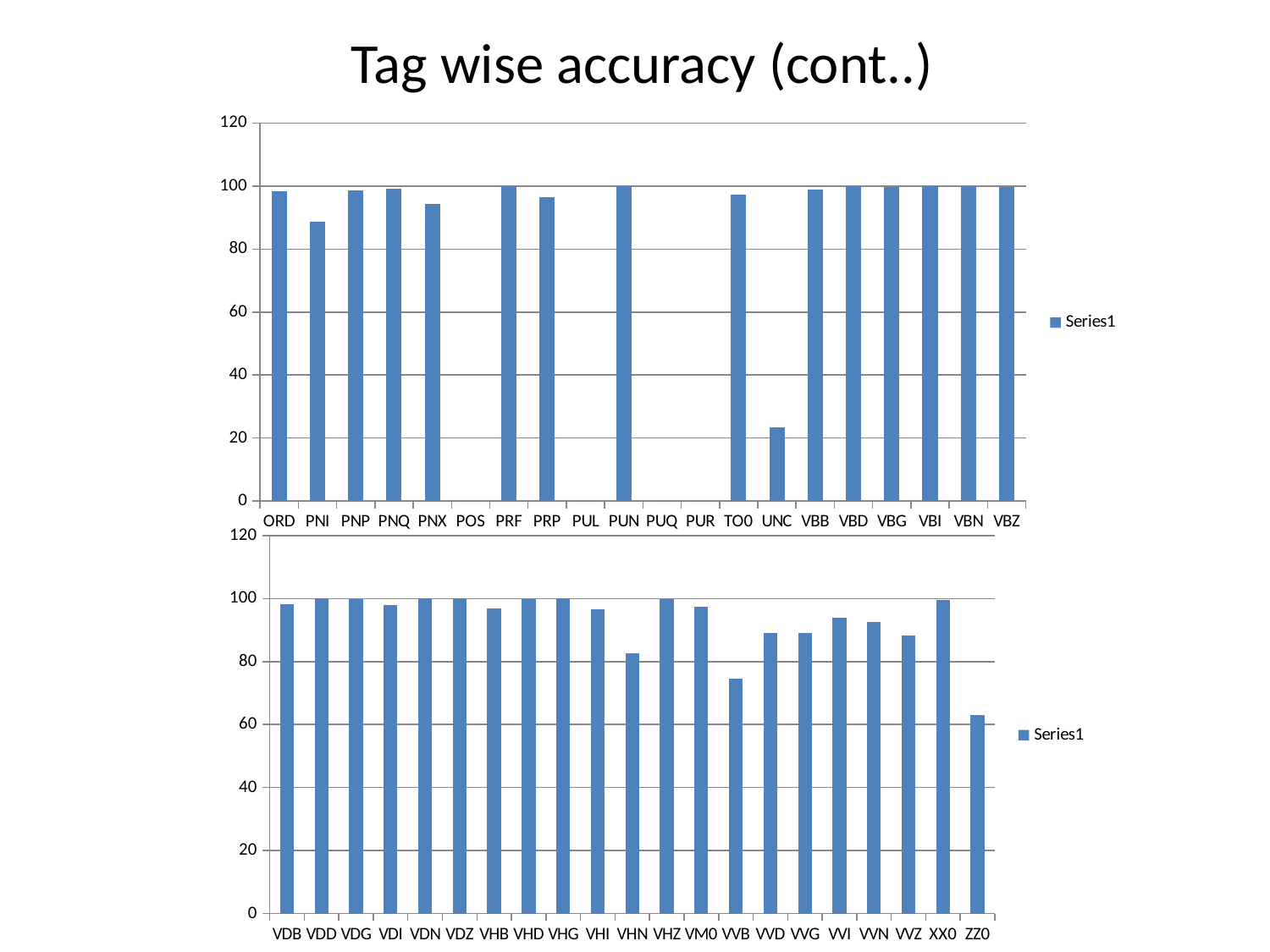
What is the title of the slide? Tag wise accuracy (cont..) How many series does the legend of the bottom chart list? 1 In the bottom chart, is the value for ZZ0 greater or less than 80? less In the top chart, is the value for UNC greater or less than 40? less In the bottom chart, how many categories are shown on the x axis? 21 In the bottom chart, which is larger, the value for VHN or the value for VVB? VHN In the top chart, which category has the lowest bar? UNC What kind of chart is the top chart on the slide? bar chart In the bottom chart, which category has the lowest bar? ZZ0 In the bottom chart, is the value for VVB greater or less than 80? less In the top chart, how many categories are shown on the x axis? 20